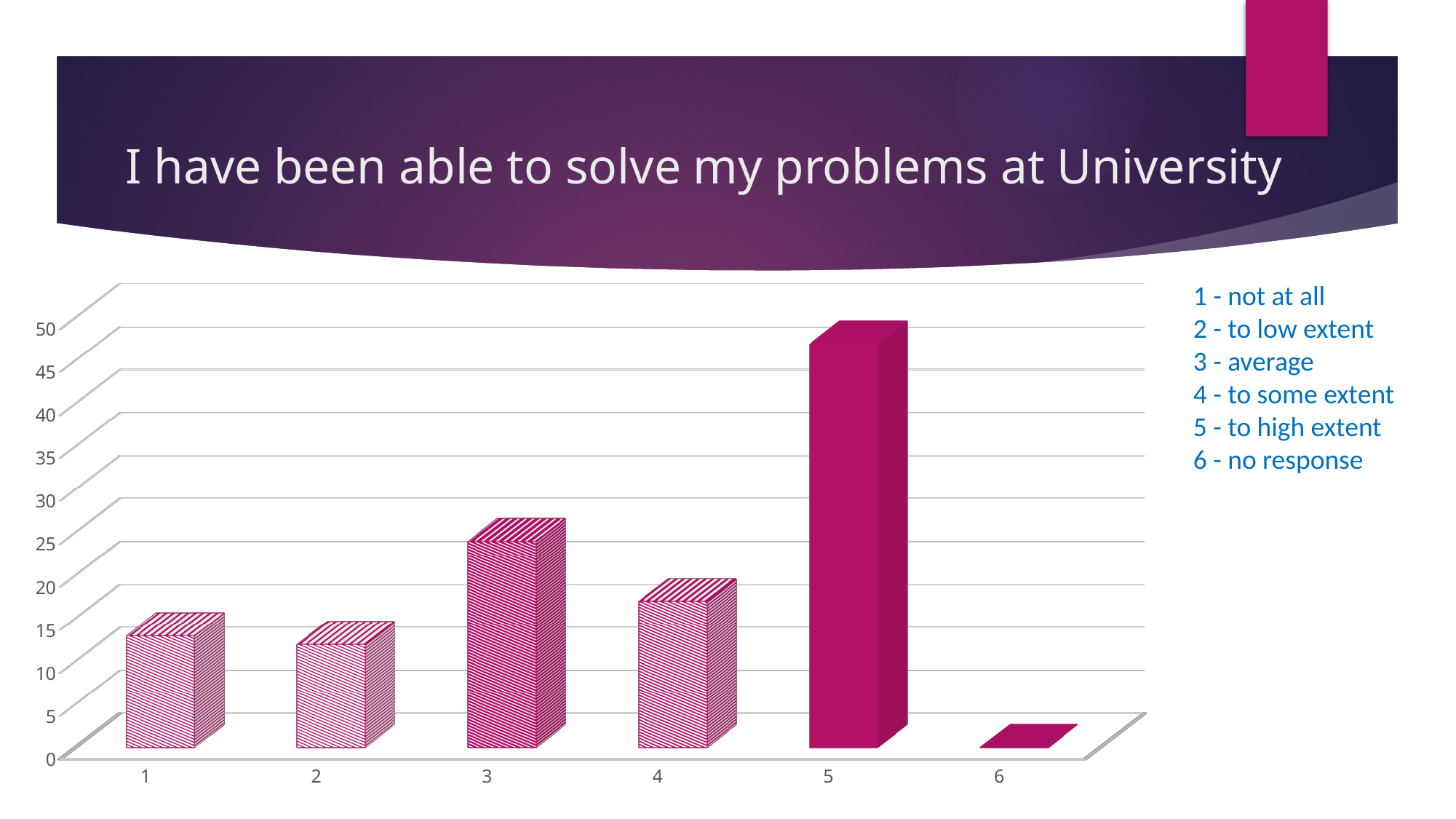
How many categories are shown on the x axis? 6 What is the title of the chart? I have been able to solve my problems at University Which is larger, the value for category 5 or the value for category 3? 5 Which category has the highest bar? 5 According to the key on the slide, what does category 6 stand for? no response Which is larger, the value for category 3 or the value for category 4? 3 Is the value for category 1 greater or less than 20? less What kind of chart is shown on the slide? bar chart Is the value for category 3 greater or less than 20? greater Is the value for category 6 greater or less than 5? less Which category has the lowest bar? 6